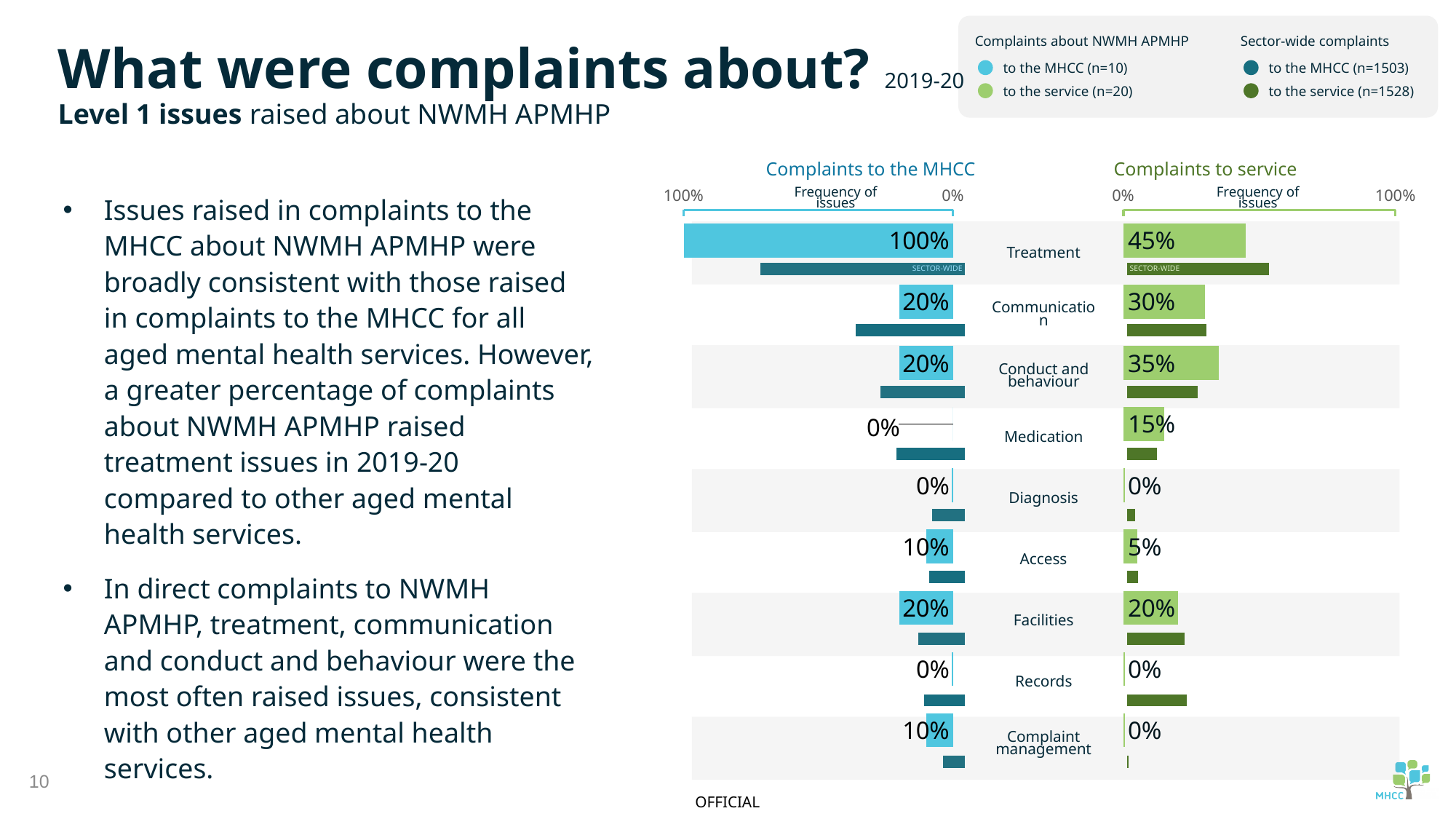
What is the difference between the Treatment values in the 'Complaints to the MHCC' chart and the 'Complaints to service' chart? 55% In the 'Complaints to service' chart, what is the difference between Communication and Access? 25% How many series does the legend at the top right list? 4 Which is larger: Communication in the 'Complaints to the MHCC' chart or Communication in the 'Complaints to service' chart? Complaints to service How many issue categories are shown in the charts? 9 In the 'Complaints to the MHCC' chart, what is the value for Access? 10% In the 'Complaints to service' chart, which category has the highest value? Treatment In the 'Complaints to service' chart, what is the value for Medication? 15% In the 'Complaints to the MHCC' chart, which category has the highest value? Treatment In the 'Complaints to the MHCC' chart, what is the value for Treatment? 100% Which is larger: the Facilities value in the 'Complaints to the MHCC' chart or the Facilities value in the 'Complaints to service' chart? They are equal (20%) In the 'Complaints to service' chart, what is the value for Conduct and behaviour? 35%